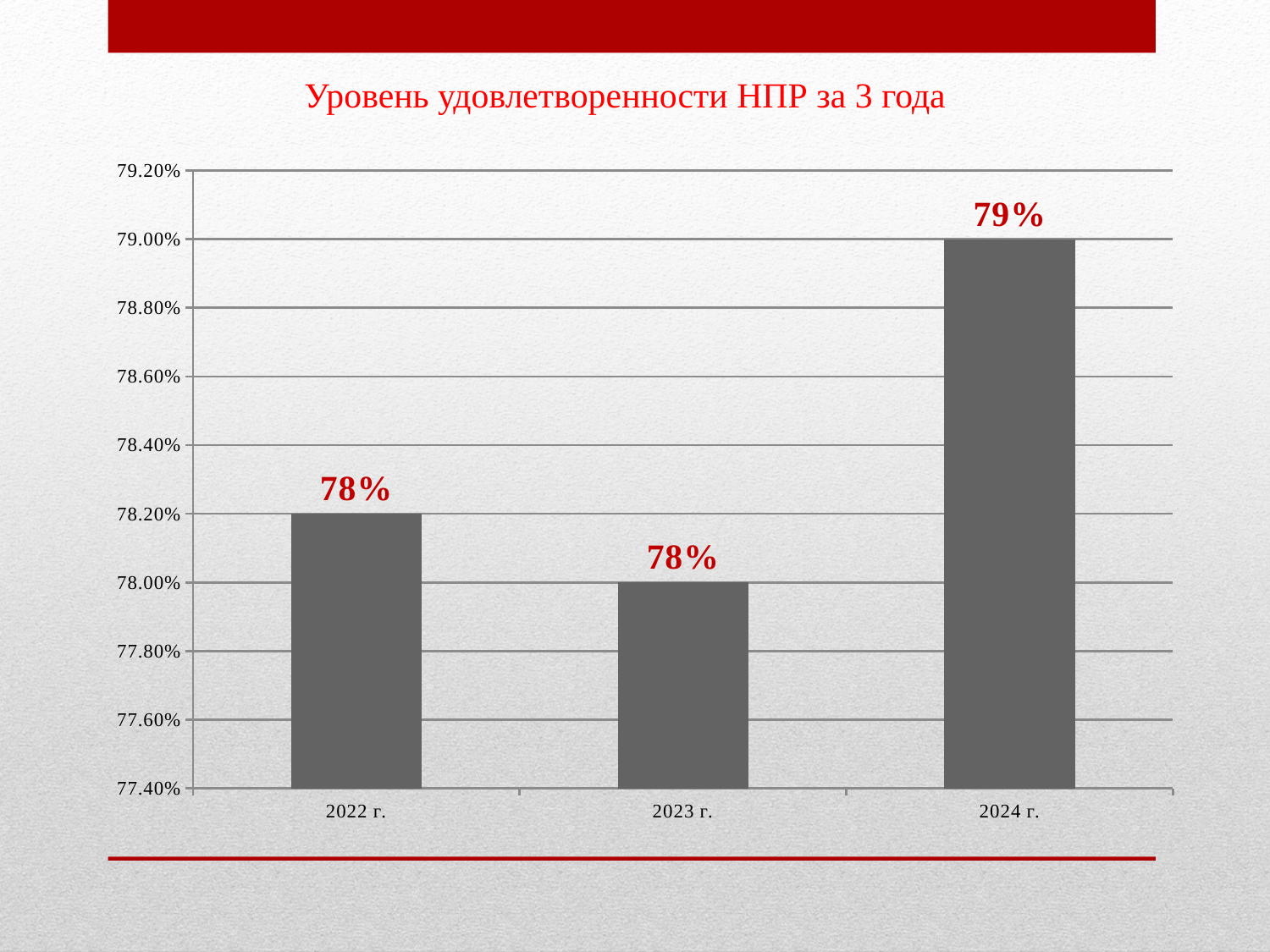
What is the data label shown for 2022 г.? 78% Which bar is taller, 2022 г. or 2023 г.? 2022 г. Is the value for 2022 г. greater or less than 78.00%? greater What is the data label shown for 2024 г.? 79% How many years are shown on the x axis? 3 Which year has the highest bar? 2024 г. Is the value for 2023 г. greater or less than 78.20%? less Which year has the lowest bar? 2023 г. What kind of chart is shown on the slide? bar chart Is the value for 2024 г. greater or less than 78.80%? greater What is the title of the chart? Уровень удовлетворенности НПР за 3 года What is the data label shown for 2023 г.? 78%